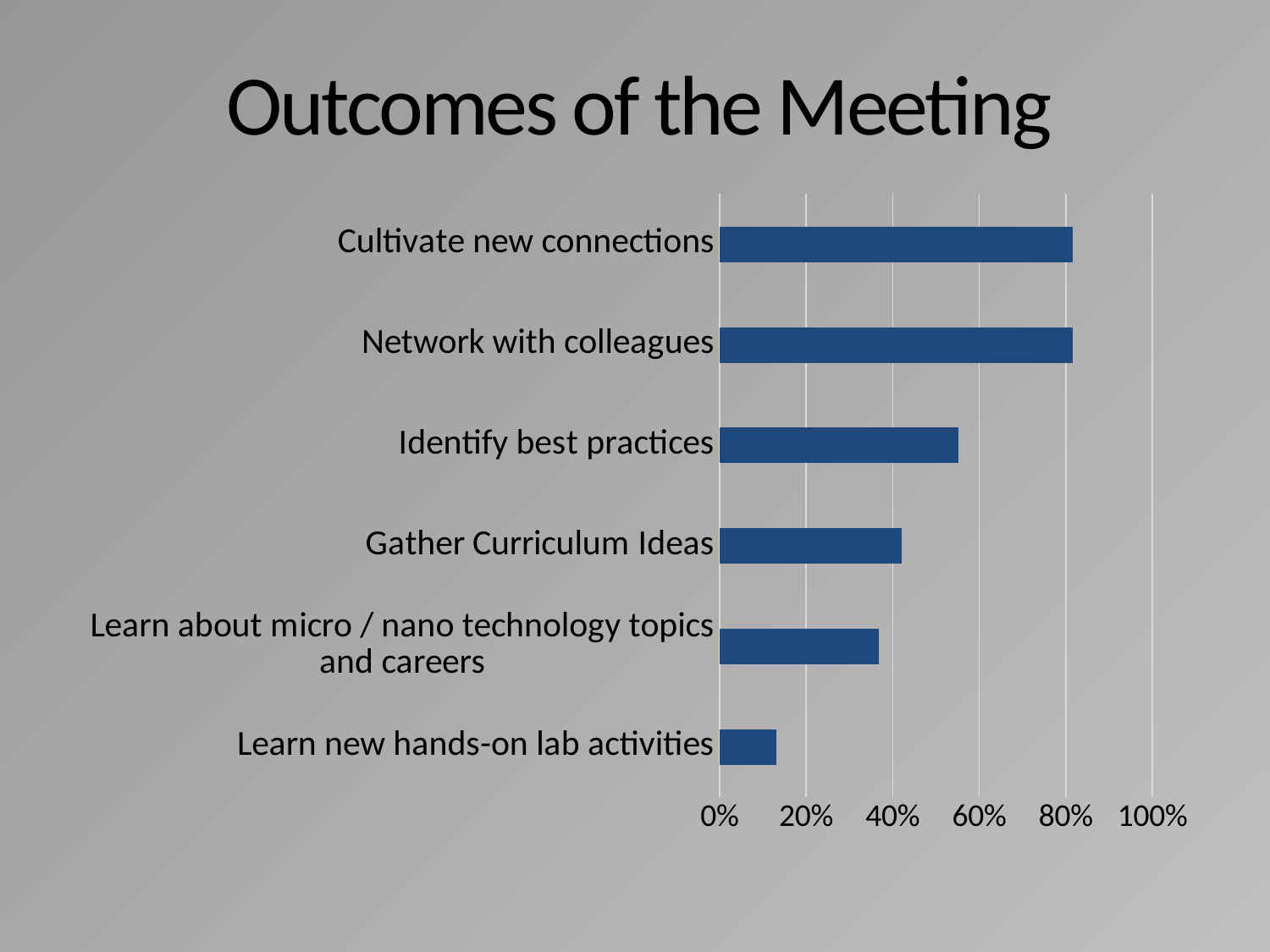
What is the title of the chart? Outcomes of the Meeting Which is larger, the value for Gather Curriculum Ideas or the value for Learn new hands-on lab activities? Gather Curriculum Ideas Which category has the lowest value? Learn new hands-on lab activities What type of chart is shown on the slide? bar chart How many categories are plotted in the chart? 6 Is the value for Learn new hands-on lab activities greater or less than 20%? less Is the value for Network with colleagues greater or less than 60%? greater Is the value for Identify best practices greater or less than 40%? greater Which is larger, the value for Identify best practices or the value for Learn about micro / nano technology topics and careers? Identify best practices